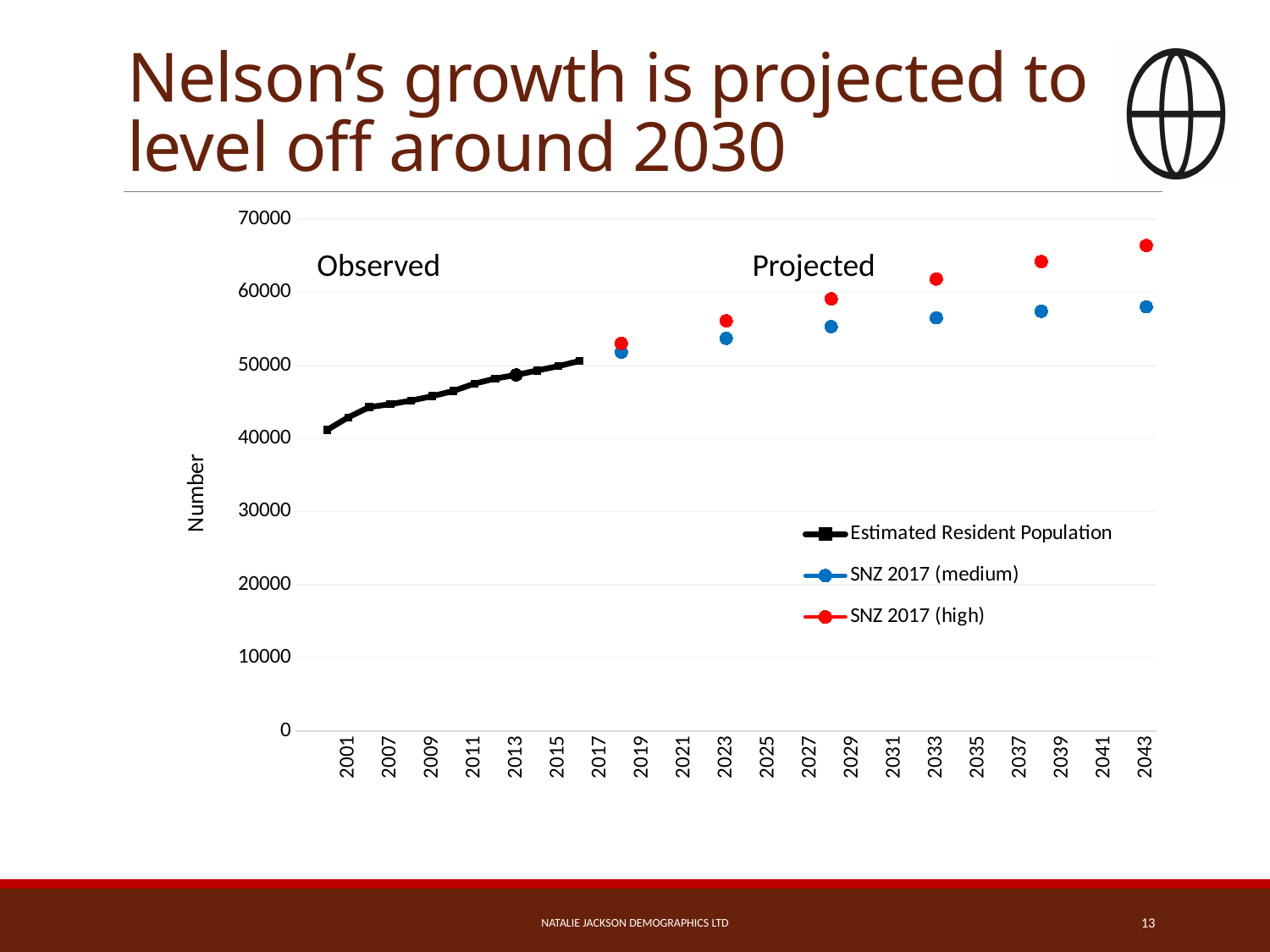
How many series does the chart legend list? 3 What is the title of the slide containing the chart? Nelson's growth is projected to level off around 2030 Is the value for SNZ 2017 (medium) in 2043 greater or less than 60000? less Does the Estimated Resident Population series rise or fall from 2001 to 2016? rise In 2043, which series has the larger value: SNZ 2017 (high) or SNZ 2017 (medium)? SNZ 2017 (high) Is the value for SNZ 2017 (medium) in 2028 greater or less than 50000? greater Which series reaches the highest value on the chart? SNZ 2017 (high) Does the SNZ 2017 (high) series rise or fall from 2018 to 2043? rise Is the value for SNZ 2017 (high) in 2043 greater or less than 60000? greater What is the label on the vertical axis of the chart? Number What kind of chart is shown on the slide? line chart